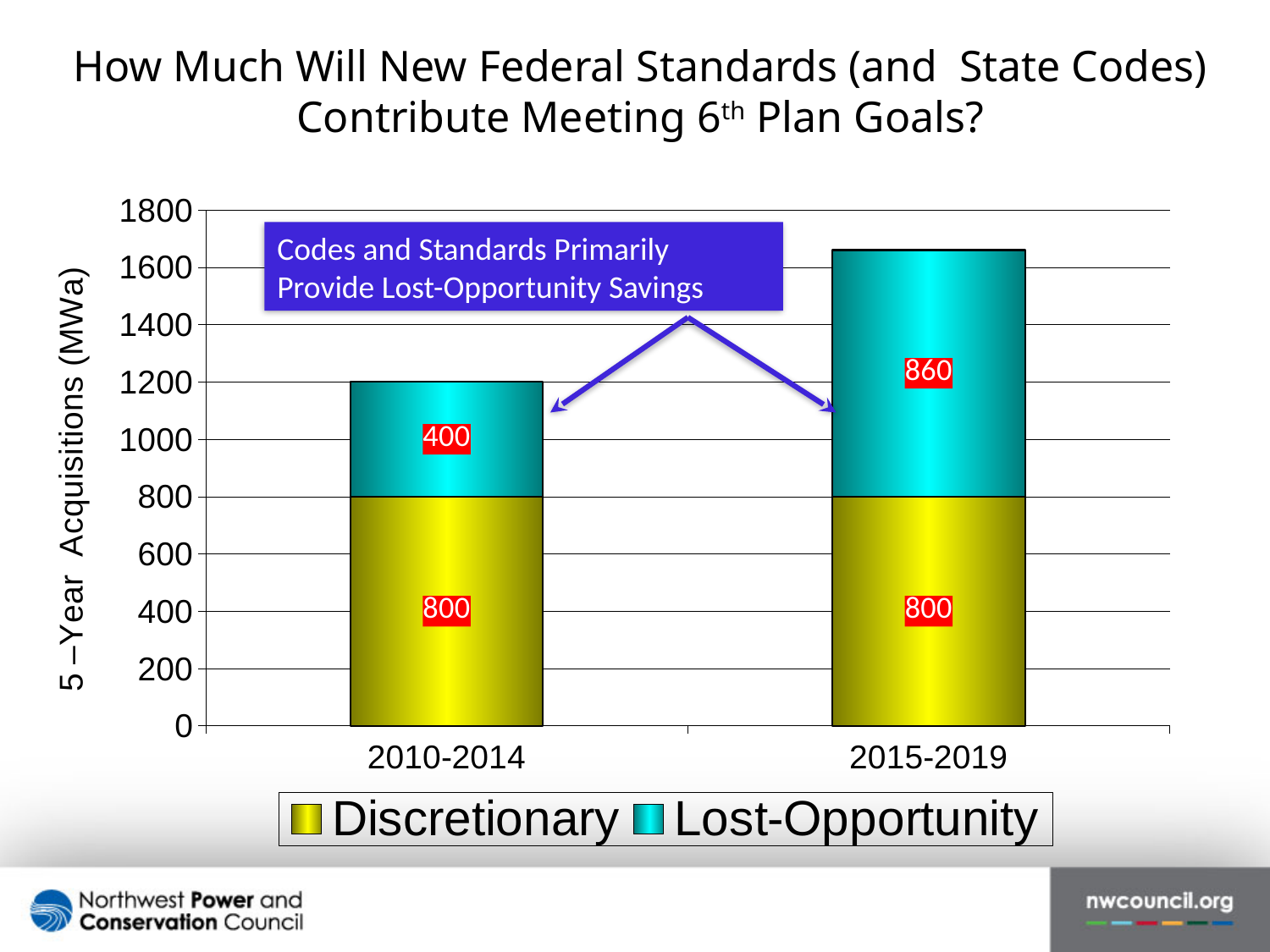
Which period has the higher Lost-Opportunity value? 2015-2019 What is the Discretionary value for 2015-2019? 800 What is the total of the stacked bar for 2010-2014? 1200 What kind of chart is shown on the slide? stacked bar chart What is the Lost-Opportunity value for 2015-2019? 860 What is the total of the stacked bar for 2015-2019? 1660 What is the difference between the Lost-Opportunity values for 2015-2019 and 2010-2014? 460 How many periods are shown on the x axis? 2 What is the label of the y axis? 5 –Year Acquisitions (MWa) What is the Lost-Opportunity value for 2010-2014? 400 Is the Discretionary value for 2010-2014 larger or smaller than the Lost-Opportunity value for 2010-2014? larger How many series does the legend list? 2